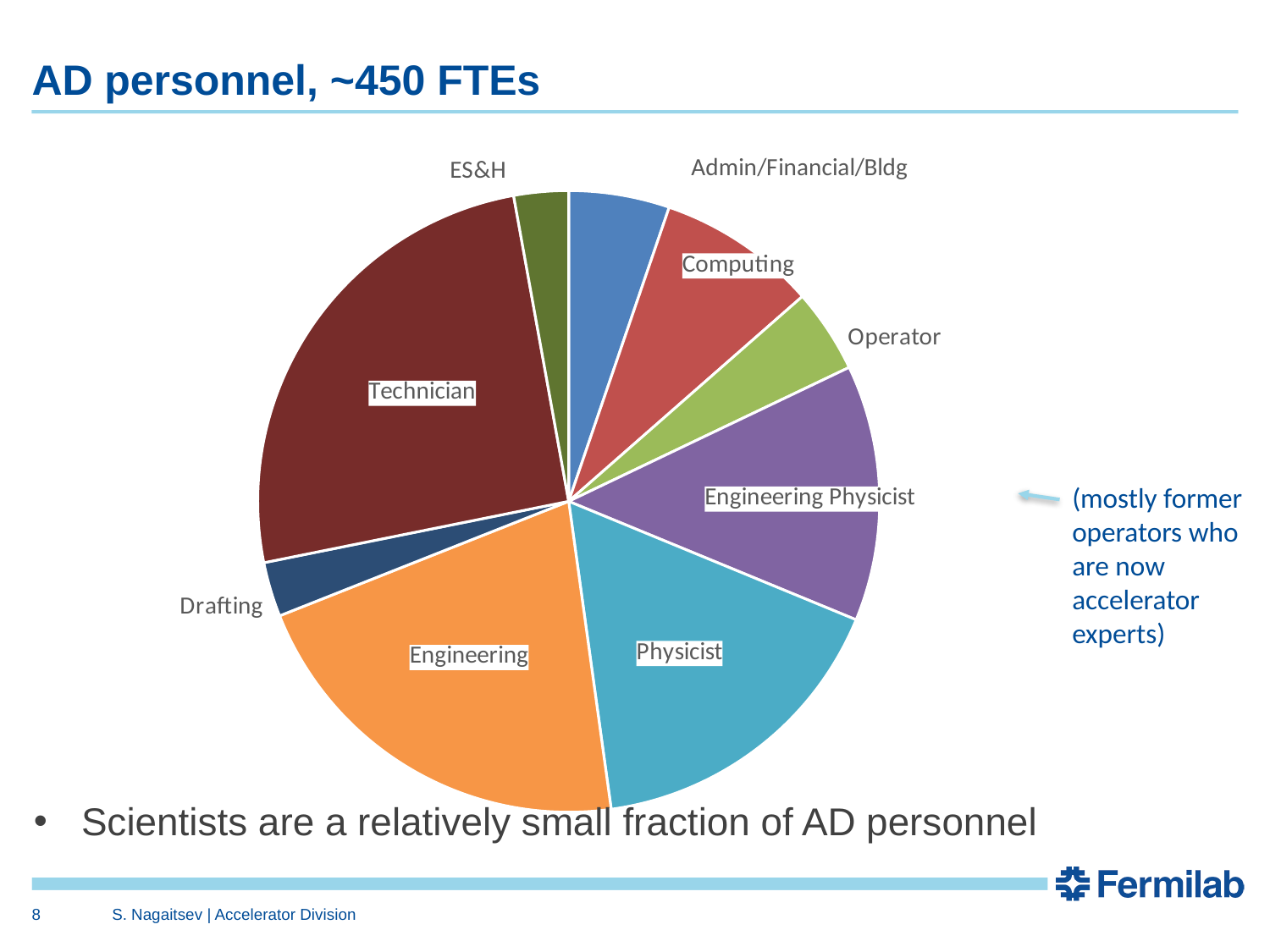
Which slice is larger, Engineering Physicist or Operator? Engineering Physicist Which slice is larger, Computing or ES&H? Computing How many slices does the pie chart have? 9 What is the title of the slide containing the pie chart? AD personnel, ~450 FTEs Which slice is larger, Technician or Physicist? Technician Which category has the largest slice of the pie chart? Technician Which slice of the pie chart does the annotation "(mostly former operators who are now accelerator experts)" point to? Engineering Physicist What kind of chart is shown on the slide? pie chart